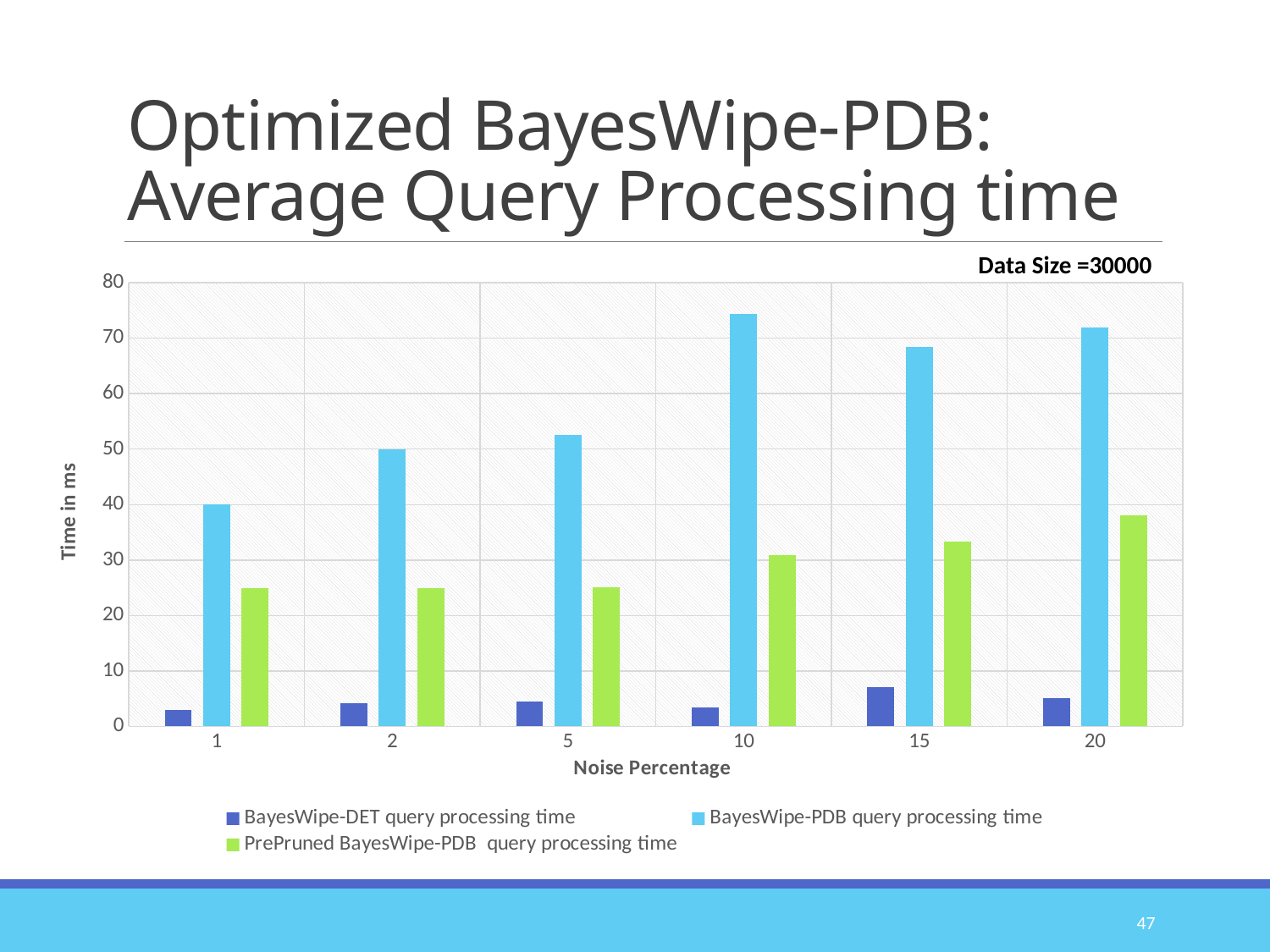
Is the PrePruned BayesWipe-PDB query processing time at noise percentage 5 greater or less than 30? less What kind of chart is shown on the slide? bar chart At which noise percentage is the BayesWipe-PDB query processing time highest? 10 Is the BayesWipe-PDB query processing time at noise percentage 10 greater or less than 70? greater Is the BayesWipe-DET query processing time at noise percentage 15 greater or less than 10? less How many series does the legend list? 3 At which noise percentage is the PrePruned BayesWipe-PDB query processing time highest? 20 At which noise percentage is the BayesWipe-PDB query processing time lowest? 1 At noise percentage 20, which series has the larger query processing time: BayesWipe-PDB or PrePruned BayesWipe-PDB? BayesWipe-PDB Does the PrePruned BayesWipe-PDB query processing time generally rise or fall as the noise percentage increases? rise How many noise percentage categories are shown on the x axis? 6 What data size is stated on the chart? 30000